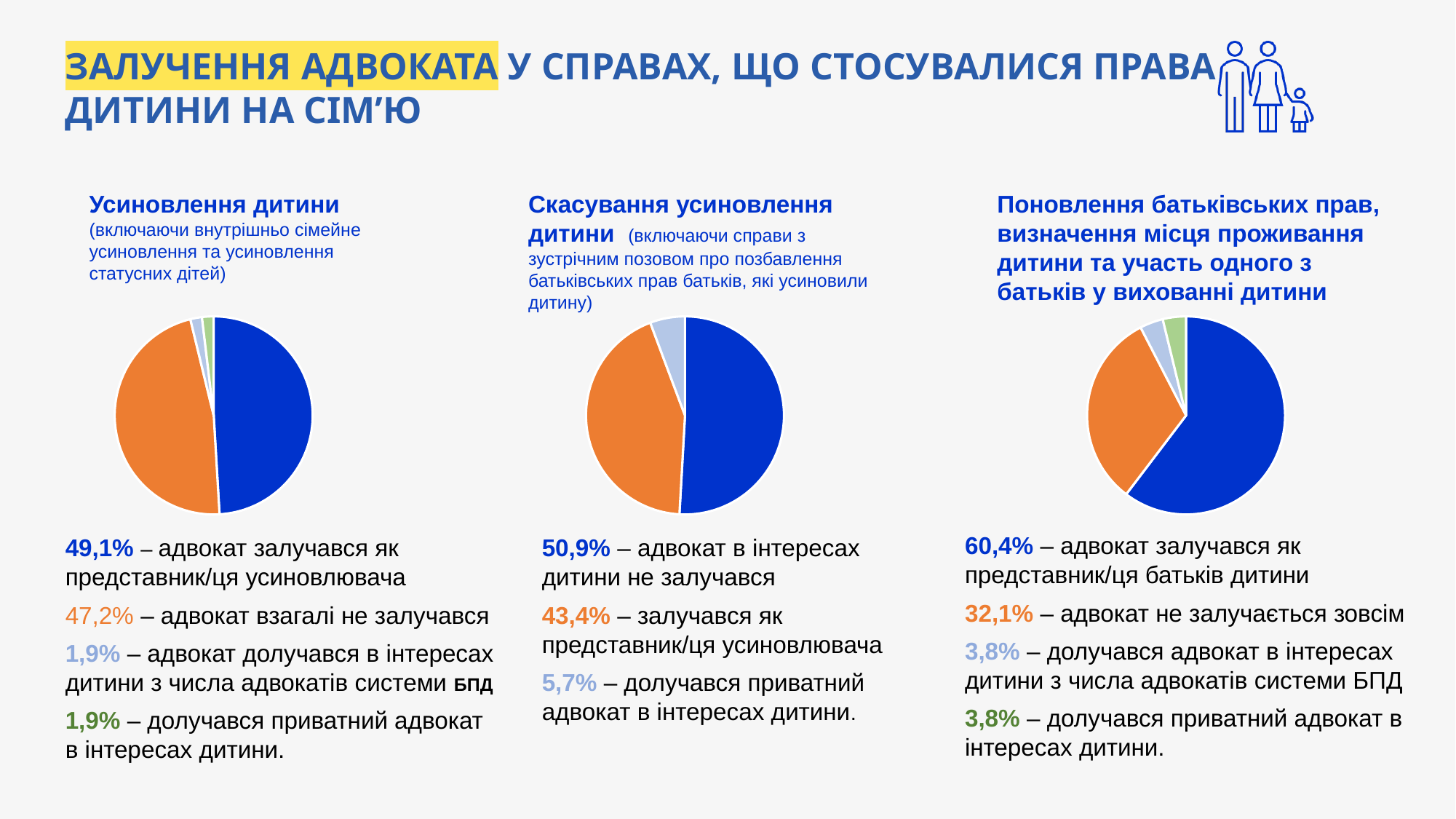
In the "Скасування усиновлення дитини" chart, what share of cases had no lawyer involved in the child's interests (адвокат в інтересах дитини не залучався)? 50,9% How many slices does the "Скасування усиновлення дитини" pie chart have? 3 In the "Скасування усиновлення дитини" chart, which category is the smallest? долучався приватний адвокат в інтересах дитини What kind of chart is used for "Усиновлення дитини"? Pie chart Which is larger: the share of cases with no lawyer involved in the "Усиновлення дитини" chart or in the "Поновлення батьківських прав" chart? Усиновлення дитини (47,2%) In the "Поновлення батьківських прав" chart, what is the difference between the share where the lawyer represented the parents and the share where no lawyer was involved? 28,3% In the "Усиновлення дитини" chart, what share of cases had the lawyer involved as representative of the adopter (адвокат залучався як представник/ця усиновлювача)? 49,1% In the "Усиновлення дитини" chart, what is the difference between the share where the lawyer represented the adopter and the share where no lawyer was involved? 1,9% In the "Поновлення батьківських прав" chart, what share of cases had the lawyer involved as representative of the child's parents? 60,4% In the "Скасування усиновлення дитини" chart, what share of cases had a private lawyer involved in the child's interests? 5,7% In the "Поновлення батьківських прав" chart, which category is the largest? адвокат залучався як представник/ця батьків дитини In the "Усиновлення дитини" chart, what share of cases had no lawyer involved at all (адвокат взагалі не залучався)? 47,2%